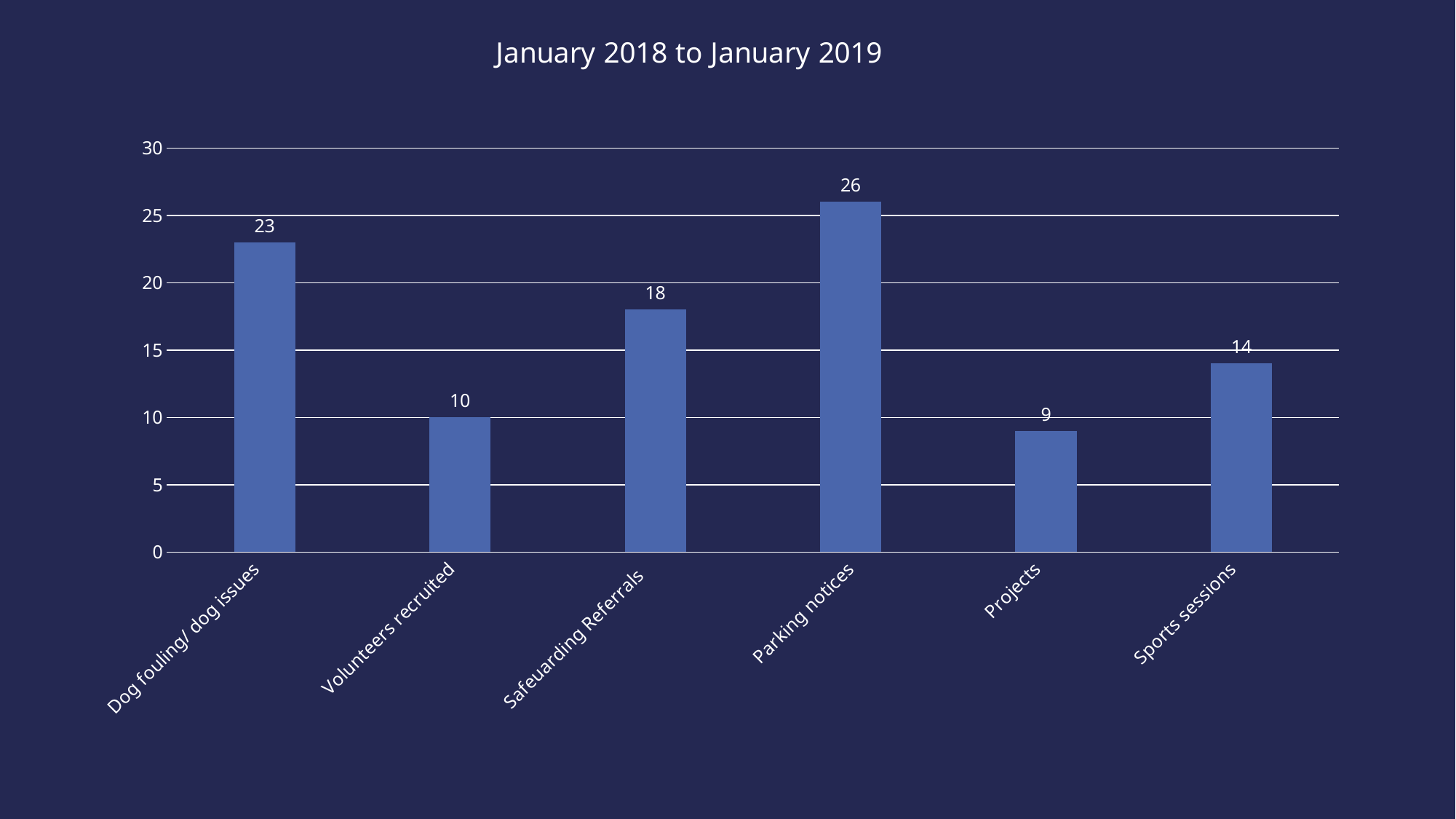
Which category has the lowest value? Projects What is the value for Sports sessions? 14 Which category has the highest value? Parking notices What is the value for Volunteers recruited? 10 What is the difference between the values for Parking notices and Projects? 17 What is the title of the chart? January 2018 to January 2019 What is the value for Parking notices? 26 Is the value for Dog fouling/ dog issues greater or less than 20? greater What is the difference between the values for Dog fouling/ dog issues and Safeuarding Referrals? 5 How many categories are shown on the x axis? 6 Which is larger, the value for Sports sessions or the value for Volunteers recruited? Sports sessions What kind of chart is shown on the slide? bar chart